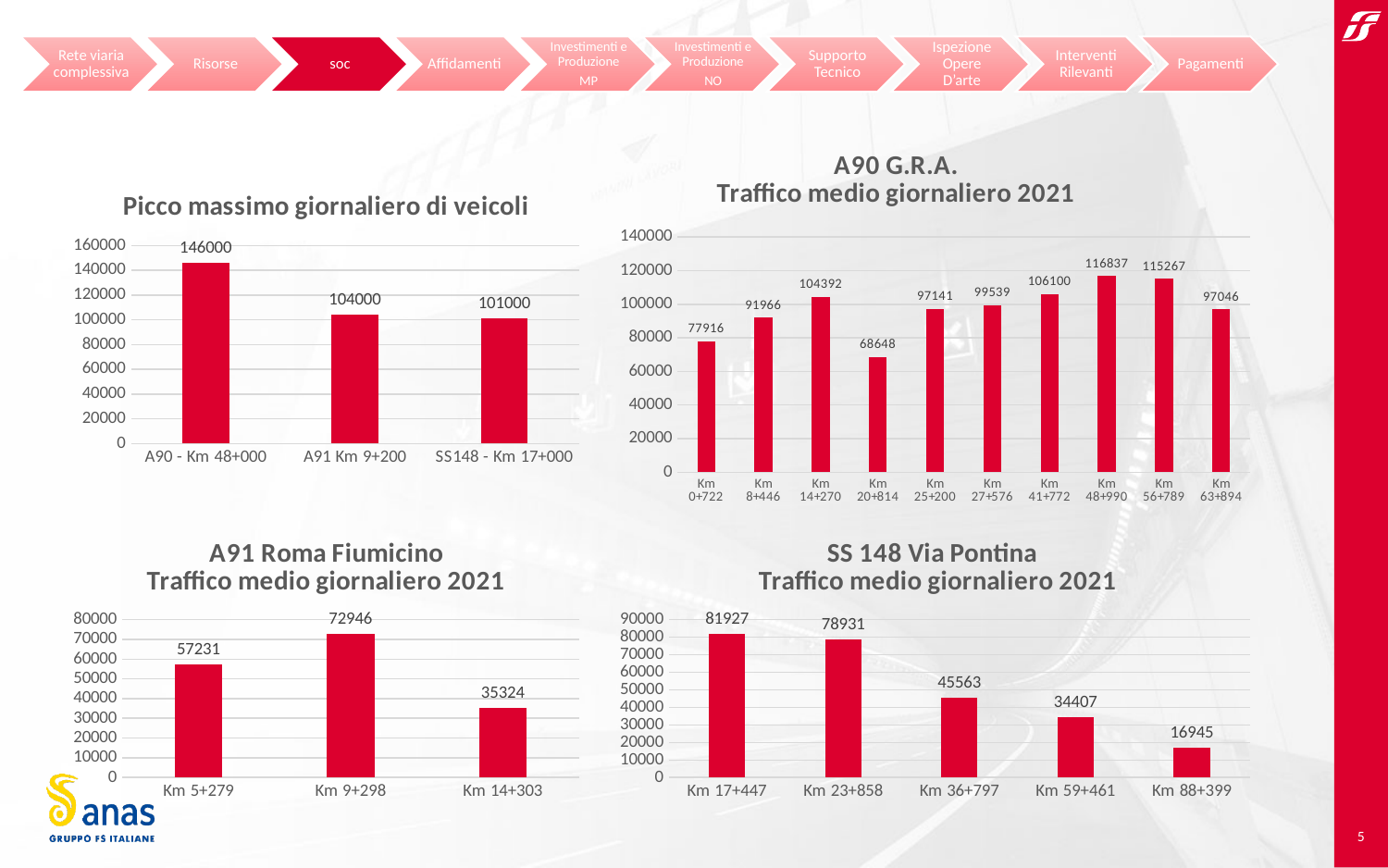
In the 'A91 Roma Fiumicino Traffico medio giornaliero 2021' chart, what is the difference between Km 9+298 and Km 5+279? 15715 In the 'SS 148 Via Pontina Traffico medio giornaliero 2021' chart, what is the value for Km 59+461? 34407 How many categories are plotted in the 'A90 G.R.A. Traffico medio giornaliero 2021' chart? 10 In the 'A91 Roma Fiumicino Traffico medio giornaliero 2021' chart, what is the value for Km 14+303? 35324 In the 'A90 G.R.A. Traffico medio giornaliero 2021' chart, which category has the highest value? Km 48+990 In the 'A90 G.R.A. Traffico medio giornaliero 2021' chart, which is larger, Km 8+446 or Km 63+894? Km 63+894 In the 'A90 G.R.A. Traffico medio giornaliero 2021' chart, which category has the lowest value? Km 20+814 In the 'SS 148 Via Pontina Traffico medio giornaliero 2021' chart, do the values rise or fall from left to right along the x axis? fall In the 'Picco massimo giornaliero di veicoli' chart, what is the difference between A91 Km 9+200 and SS148 - Km 17+000? 3000 In the 'A90 G.R.A. Traffico medio giornaliero 2021' chart, what is the value for Km 14+270? 104392 In the 'Picco massimo giornaliero di veicoli' chart, what is the value for A90 - Km 48+000? 146000 What kind of chart is the 'SS 148 Via Pontina Traffico medio giornaliero 2021' chart? bar chart